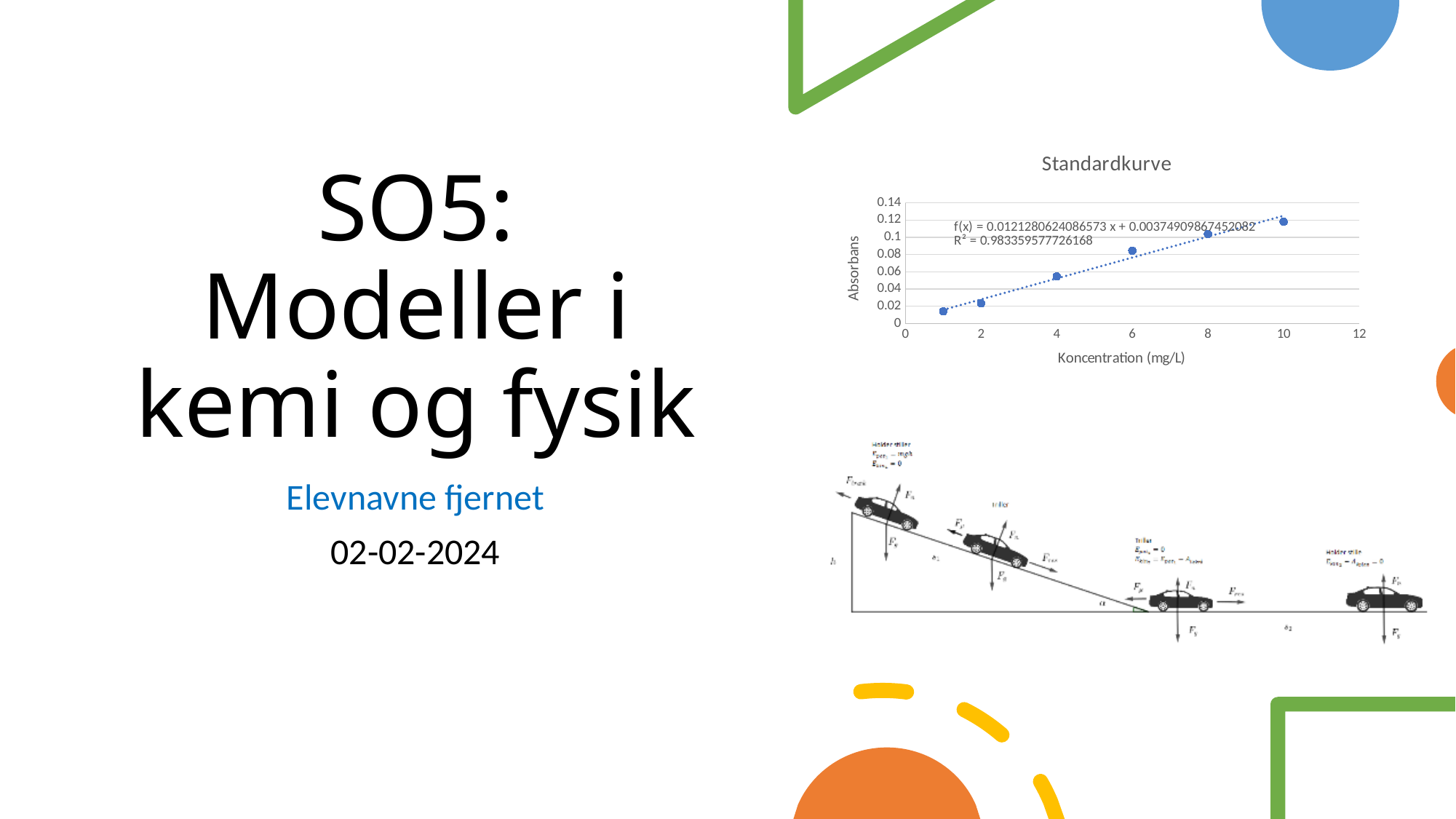
In the Standardkurve chart, is the absorbance at concentration 10 greater or less than 0.1? greater How many data points are plotted in the Standardkurve chart? 6 What is the x-axis label of the Standardkurve chart? Koncentration (mg/L) In the Standardkurve chart, is the absorbance at concentration 4 greater or less than 0.04? greater In the Standardkurve chart, which concentration has the lowest absorbance? 1 In the Standardkurve chart, which has the larger absorbance: concentration 8 or concentration 4? 8 In the Standardkurve chart, is the absorbance at concentration 1 greater or less than 0.02? less In the Standardkurve chart, does absorbance rise or fall as concentration increases? rise What kind of chart is the Standardkurve chart? scatter chart What is the title of the chart on the slide? Standardkurve In the Standardkurve chart, which concentration has the highest absorbance? 10